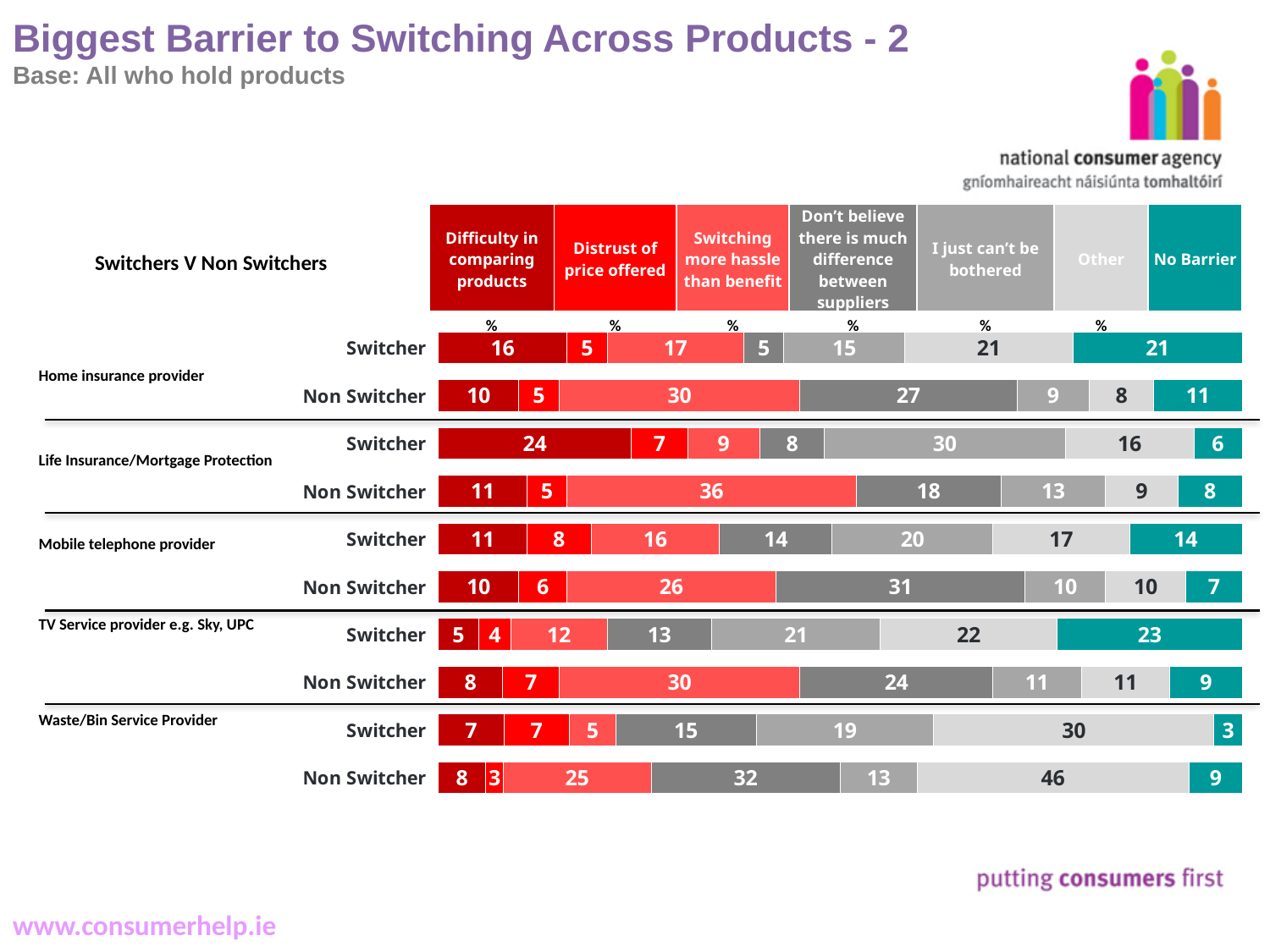
What is the difference between the 'I just can't be bothered' values for Life Insurance/Mortgage Protection Switchers and Non Switchers? 17 What kind of chart is shown on the slide? Stacked bar chart What is the value for 'Switching more hassle than benefit' for Life Insurance/Mortgage Protection Non Switchers? 36 What is the value for 'Other' for Waste/Bin Service Provider Non Switchers? 46 What is the total of the stacked bar for Mobile telephone provider Switchers? 100 How many product categories are shown in the chart? 5 Which barrier has the lowest value for Waste/Bin Service Provider Switchers? No Barrier Which barrier has the highest value for Mobile telephone provider Non Switchers? Don't believe there is much difference between suppliers Which is larger for Home insurance provider: the 'Don't believe there is much difference between suppliers' value for Switchers or for Non Switchers? Non Switchers What is the value for 'No Barrier' for TV Service provider Switchers? 23 What is the value for 'Difficulty in comparing products' for Home insurance provider Switchers? 16 How many series does the legend list? 7